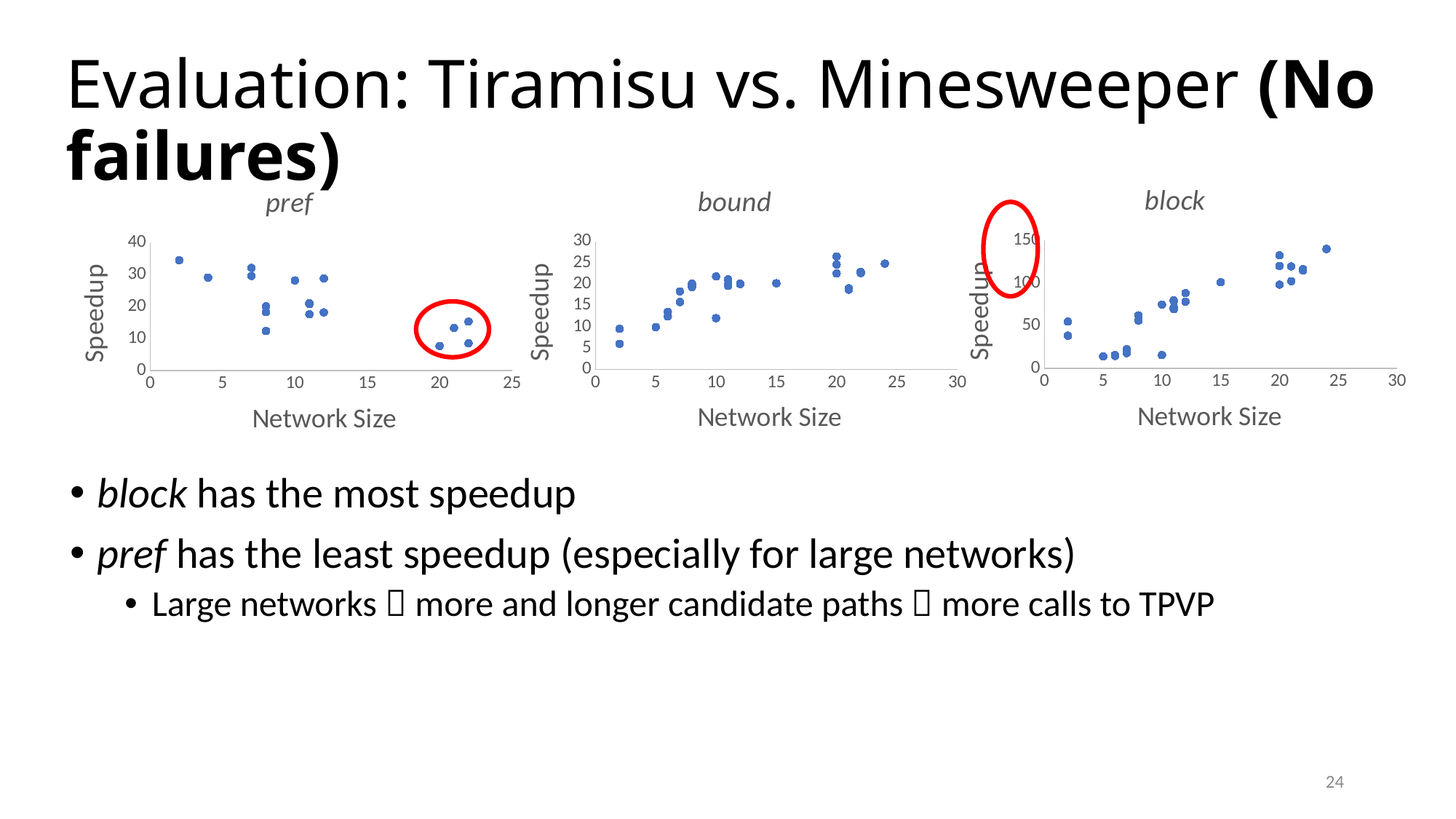
In the chart titled "block", do the speedup values generally rise or fall as network size increases? rise In the chart titled "pref", is the speedup for network size 2 greater or less than 30? greater In the chart titled "pref", do the speedup values generally rise or fall as network size increases? fall What kind of chart is the chart titled "pref"? scatter chart In the chart titled "bound", do the speedup values generally rise or fall as network size increases? rise In the chart titled "block", which has the larger speedup: network size 24 or network size 5? network size 24 In the chart titled "block", are the speedup values for network size 5 greater or less than 50? less In the chart titled "block", is the speedup for network size 24 greater or less than 100? greater How many charts are shown on the slide? 3 What is the y-axis label of the chart titled "block"? Speedup What is the x-axis label of the chart titled "bound"? Network Size